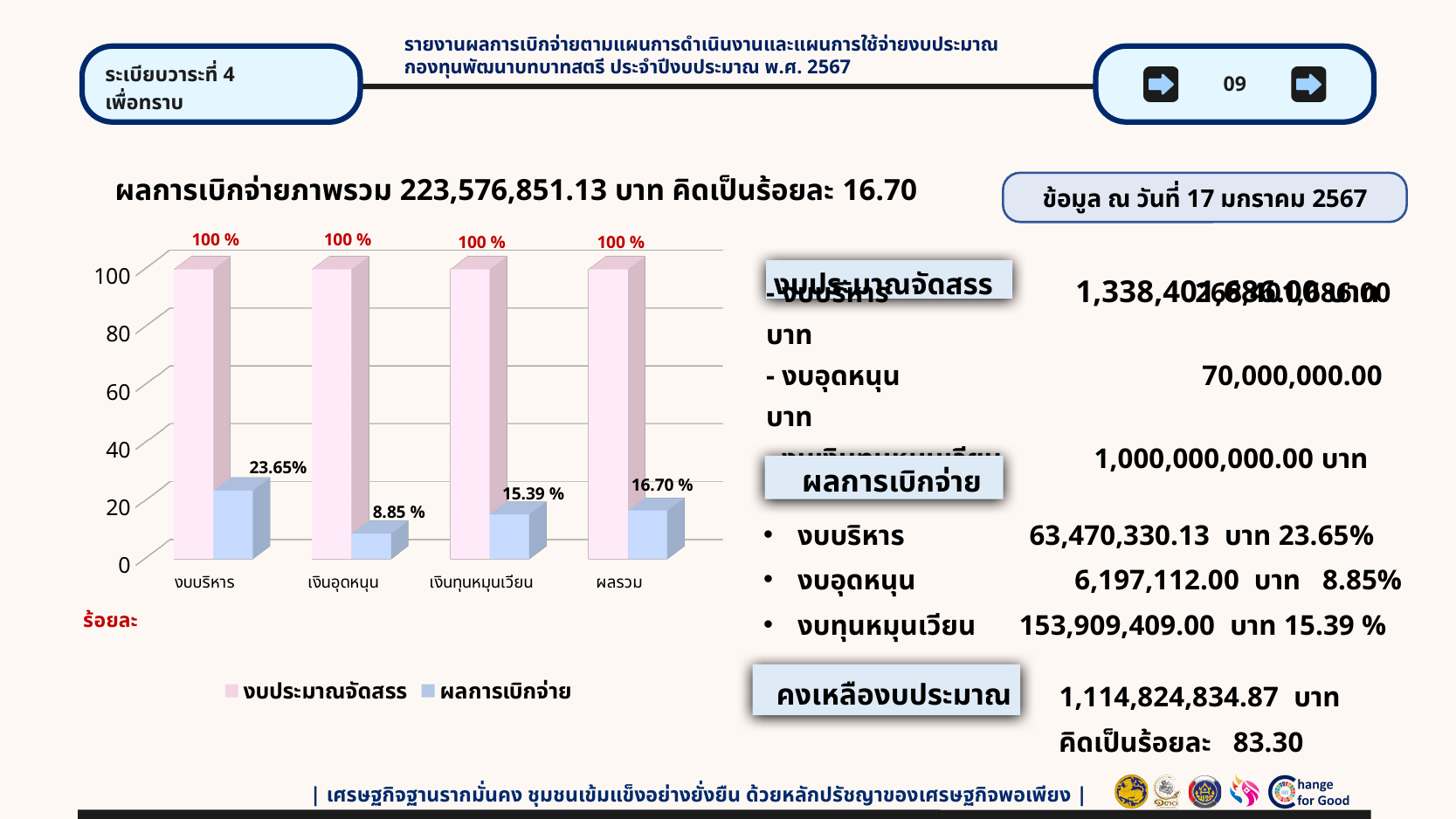
How many categories are shown on the x axis of the chart? 4 What is the difference between the ผลการเบิกจ่าย values for งบบริหาร and เงินอุดหนุน? 14.80 Which category has the highest ผลการเบิกจ่าย value? งบบริหาร What is the value of งบประมาณจัดสรร for เงินอุดหนุน? 100 % What is the value of ผลการเบิกจ่าย for ผลรวม? 16.70 % What is the value of ผลการเบิกจ่าย for งบบริหาร? 23.65% How many series does the chart legend list? 2 What is the value of ผลการเบิกจ่าย for เงินทุนหมุนเวียน? 15.39 % What kind of chart is shown on the slide? bar chart Which category has the lowest ผลการเบิกจ่าย value? เงินอุดหนุน What is the value of ผลการเบิกจ่าย for เงินอุดหนุน? 8.85 % Which is larger, the ผลการเบิกจ่าย value for เงินทุนหมุนเวียน or for ผลรวม? ผลรวม